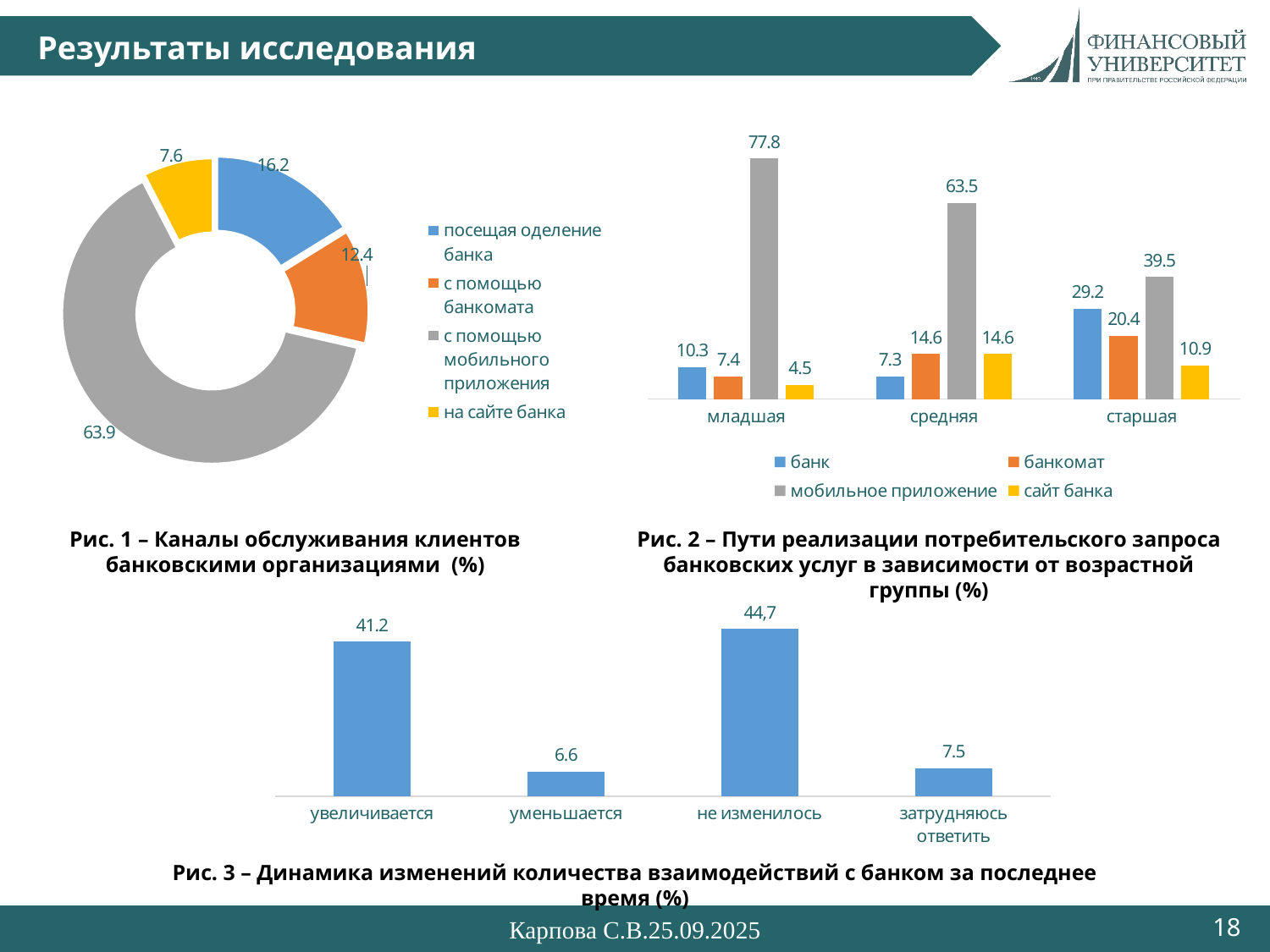
In Рис. 2 (the grouped bar chart), what is the value for 'мобильное приложение' in the 'младшая' group? 77.8 In Рис. 1 (the donut chart), what is the difference between the shares for 'посещая оделение банка' and 'с помощью банкомата'? 3.8 In Рис. 1 (the donut chart), how many legend entries are listed? 4 In Рис. 3 (the bottom bar chart), what is the value for 'не изменилось'? 44,7 In Рис. 1 (the donut chart), what share is shown for 'с помощью мобильного приложения'? 63.9 What type of chart is Рис. 3 at the bottom of the slide? bar chart In Рис. 2 (the grouped bar chart), how many age groups are shown on the x axis? 3 In Рис. 2 (the grouped bar chart), what is the value for 'банк' in the 'старшая' group? 29.2 In Рис. 2 (the grouped bar chart), does the value for 'мобильное приложение' rise or fall from 'младшая' to 'старшая'? fall In Рис. 2 (the grouped bar chart), which age group has the highest value for 'банкомат'? старшая In Рис. 1 (the donut chart), which channel has the smallest share? на сайте банка In Рис. 3 (the bottom bar chart), which category has the lowest value? уменьшается